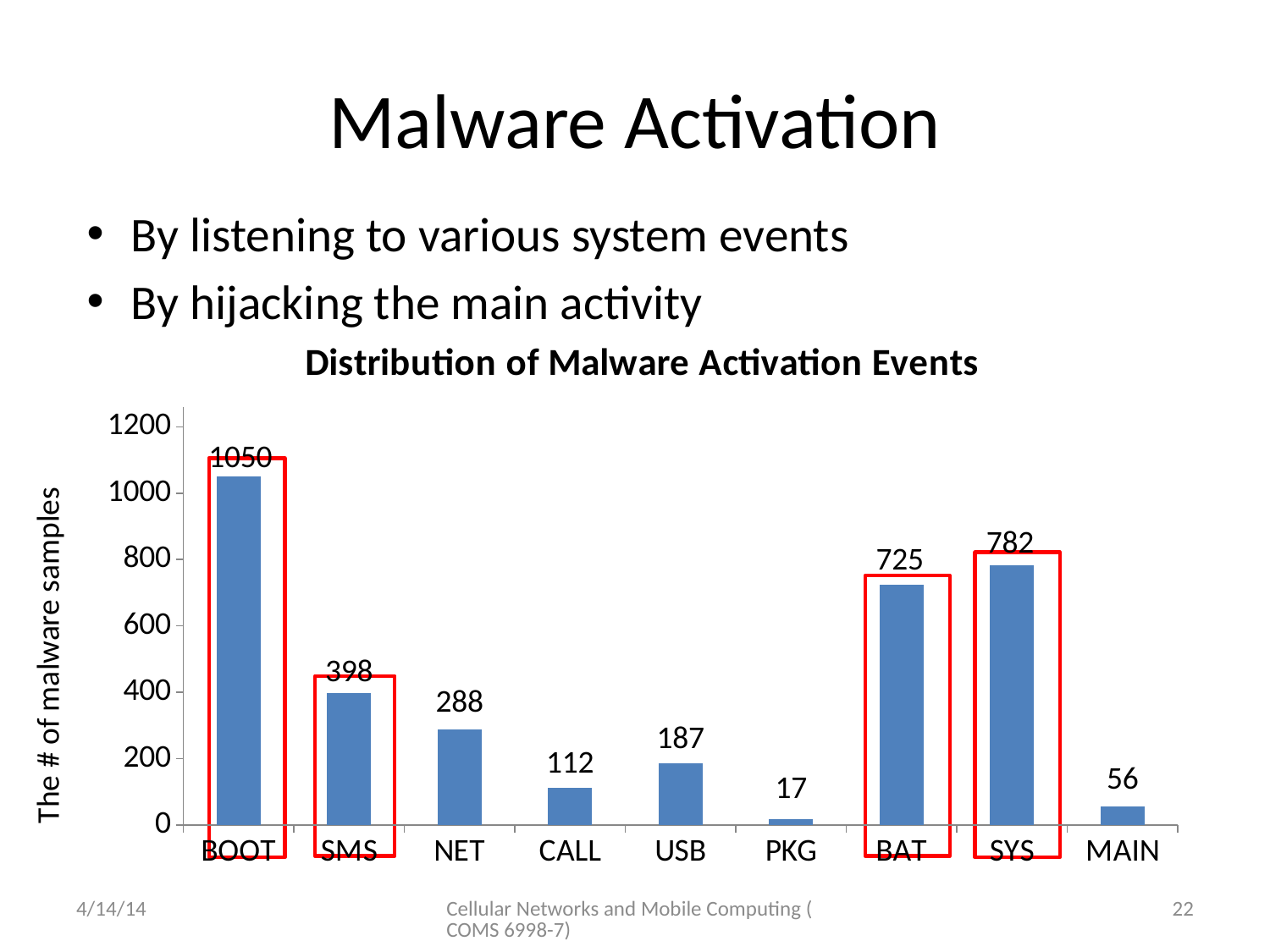
What kind of chart is this? bar chart Is the value for USB greater or less than 200? less What is the difference between the values for SYS and BAT? 57 Which category has the lowest number of malware samples? PKG What is the value for BOOT? 1050 What is the value for BAT? 725 What is the label of the y axis? The # of malware samples Which is larger, the value for SMS or the value for NET? SMS Which category has the highest number of malware samples? BOOT What is the title of the chart? Distribution of Malware Activation Events What is the value for PKG? 17 How many categories are shown on the x axis? 9